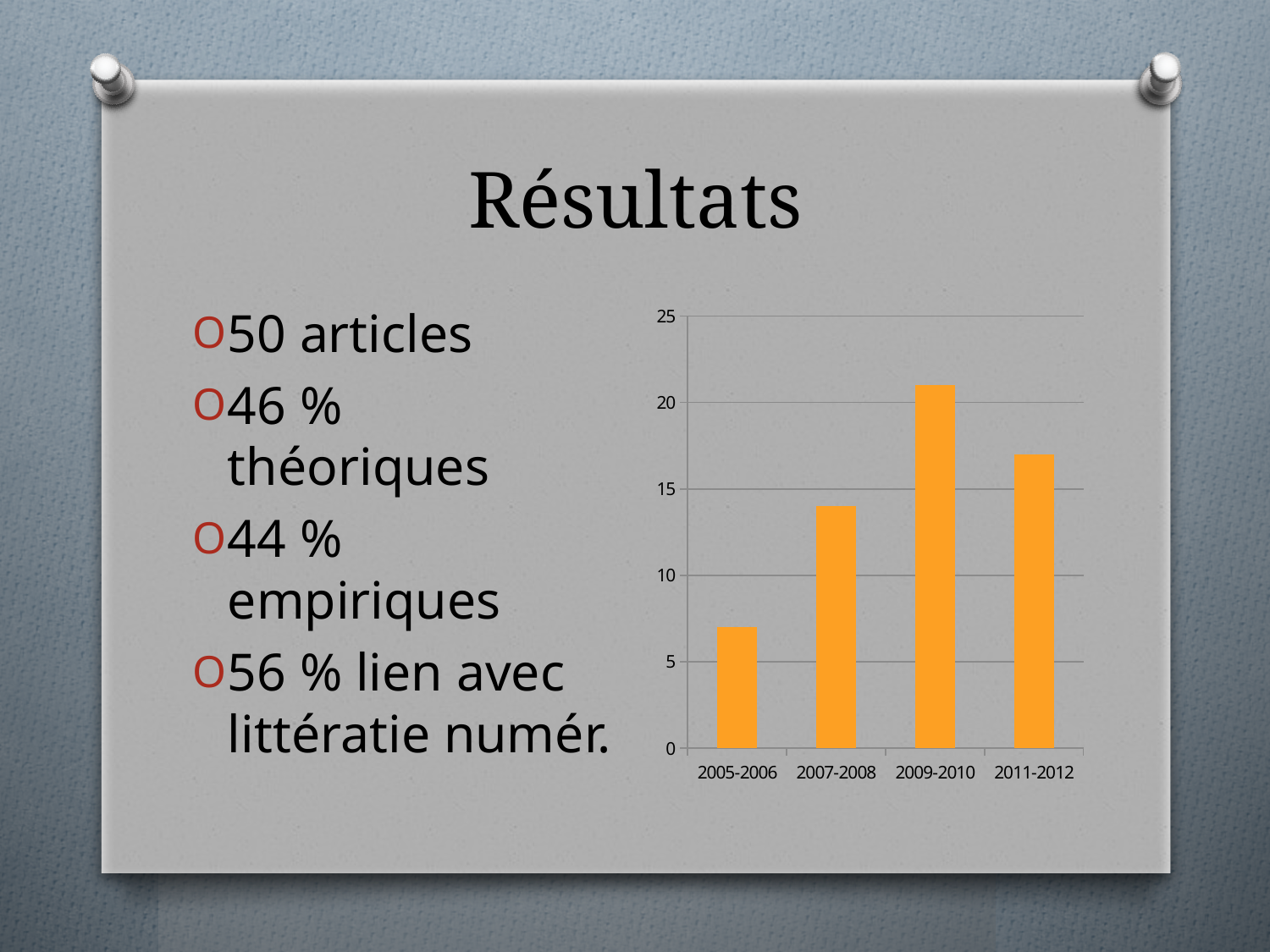
Which is larger, the value for 2005-2006 or the value for 2007-2008? 2007-2008 What is the highest value shown on the vertical axis of the chart? 25 Which category has the lowest bar in the chart? 2005-2006 Is the value for 2007-2008 greater or less than 15? less Which category has the highest bar in the chart? 2009-2010 Which is larger, the value for 2007-2008 or the value for 2011-2012? 2011-2012 What kind of chart is shown on the slide? bar chart Is the value for 2011-2012 greater or less than 15? greater How many categories are shown on the x axis of the chart? 4 Is the value for 2009-2010 greater or less than 20? greater Do the values rise or fall from 2005-2006 to 2009-2010? rise